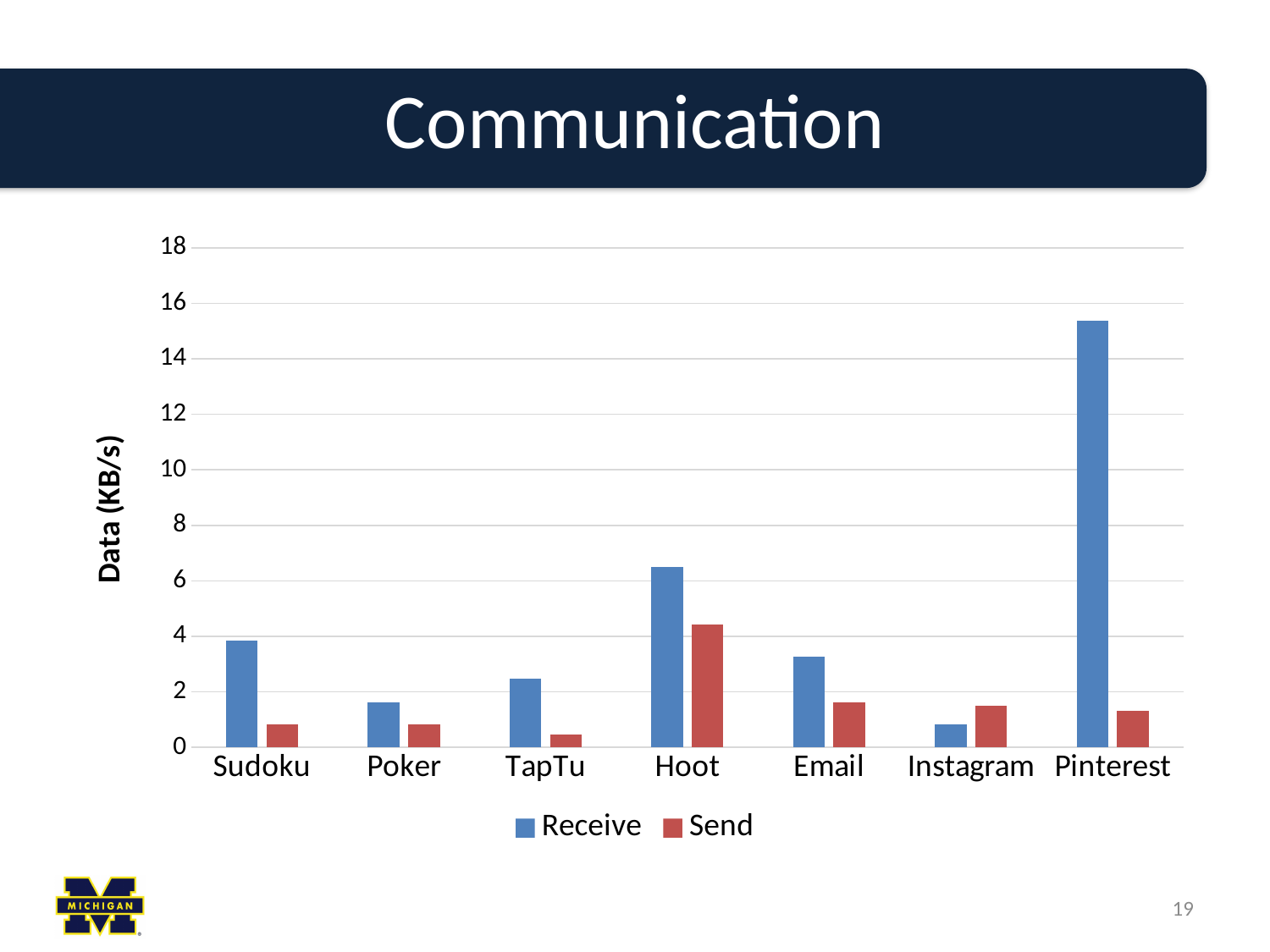
How many app categories are shown on the x axis? 7 Which app has the highest Receive value? Pinterest For Instagram, which is larger, the Receive value or the Send value? Send Is the Receive value for Instagram greater or less than 2? less How many series does the legend list? 2 Is the Receive value for Pinterest greater or less than 14? greater Is the Send value for Hoot greater or less than 4? greater Which app has the highest Send value? Hoot What kind of chart is shown on the slide? bar chart Which app has the lowest Receive value? Instagram What is the label on the y axis? Data (KB/s)